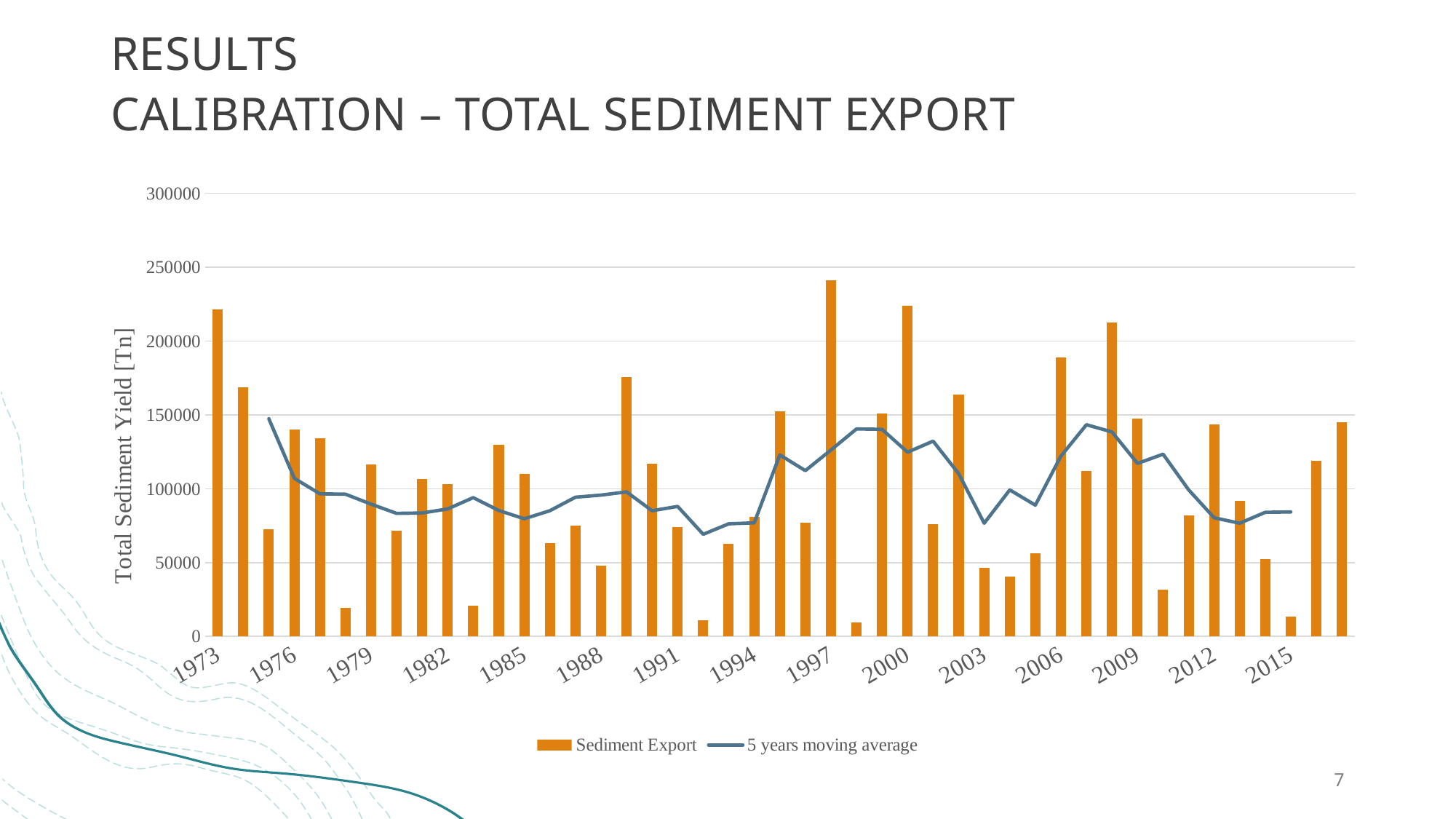
Is the Sediment Export value for 2015 greater or less than 50000? less Is the Sediment Export value for 1973 greater or less than 200000? greater Is the Sediment Export value for 2006 greater or less than 150000? greater Which year has the larger Sediment Export, 1973 or 1976? 1973 Which year has the larger Sediment Export, 2000 or 2003? 2000 What kind of chart is shown on the slide? Bar chart with a line overlay Which year has the highest Sediment Export bar? 1997 What is the label of the vertical axis? Total Sediment Yield [Tn] How many series does the legend list? 2 What are the two series named in the legend? Sediment Export; 5 years moving average